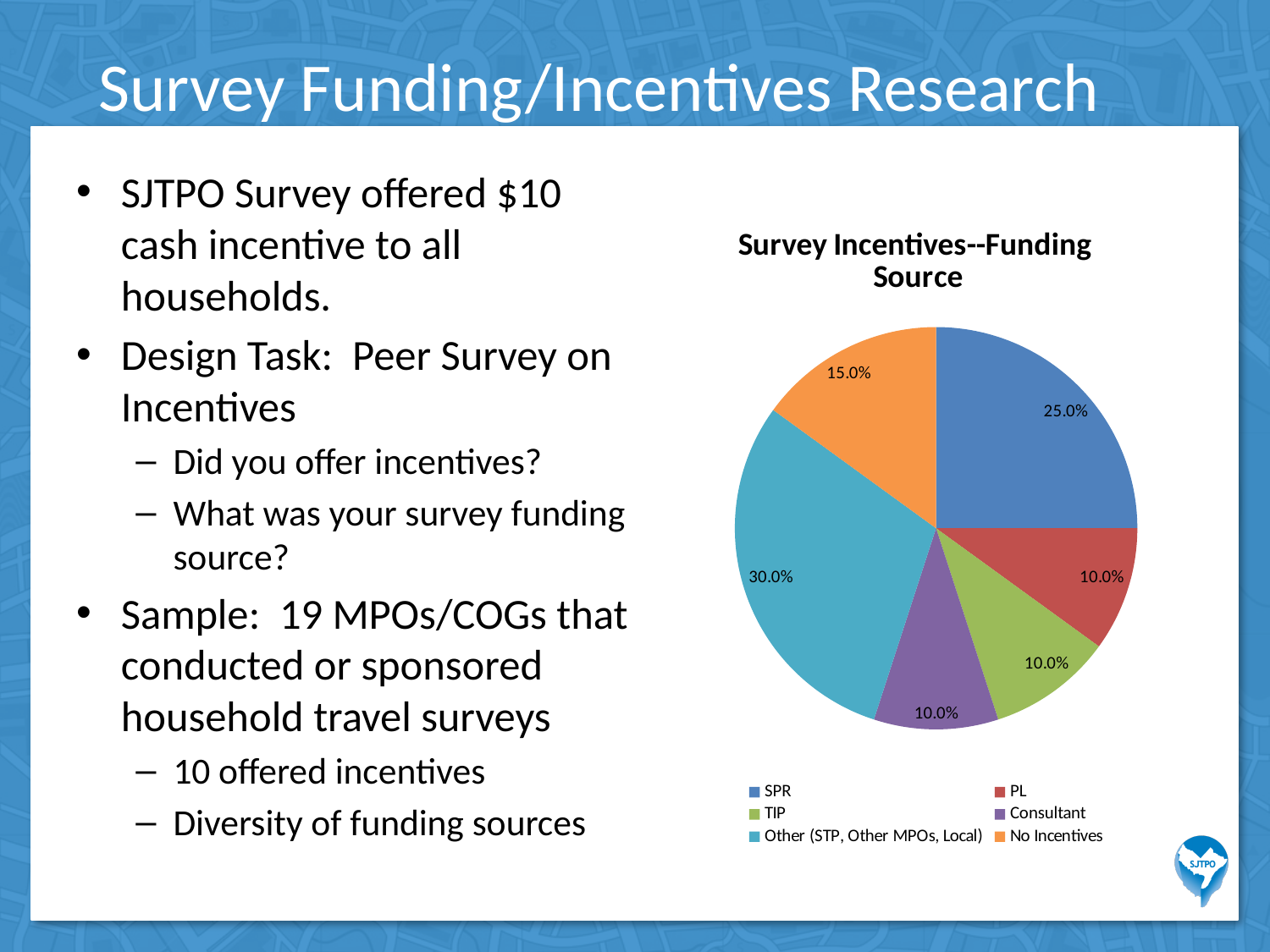
What share of the pie does Other (STP, Other MPOs, Local) represent? 30.0% What share of the pie does SPR represent? 25.0% Which is larger, the SPR slice or the No Incentives slice? SPR What share of the pie does PL represent? 10.0% What is the combined share of the PL, TIP and Consultant slices? 30.0% What is the title of the chart? Survey Incentives--Funding Source What share of the pie does No Incentives represent? 15.0% Which category has the largest slice of the pie? Other (STP, Other MPOs, Local) What is the difference in percentage points between the Other (STP, Other MPOs, Local) slice and the SPR slice? 5.0% What type of chart is shown on the slide? Pie chart How many slices does the pie chart have? 6 How many entries does the legend list? 6